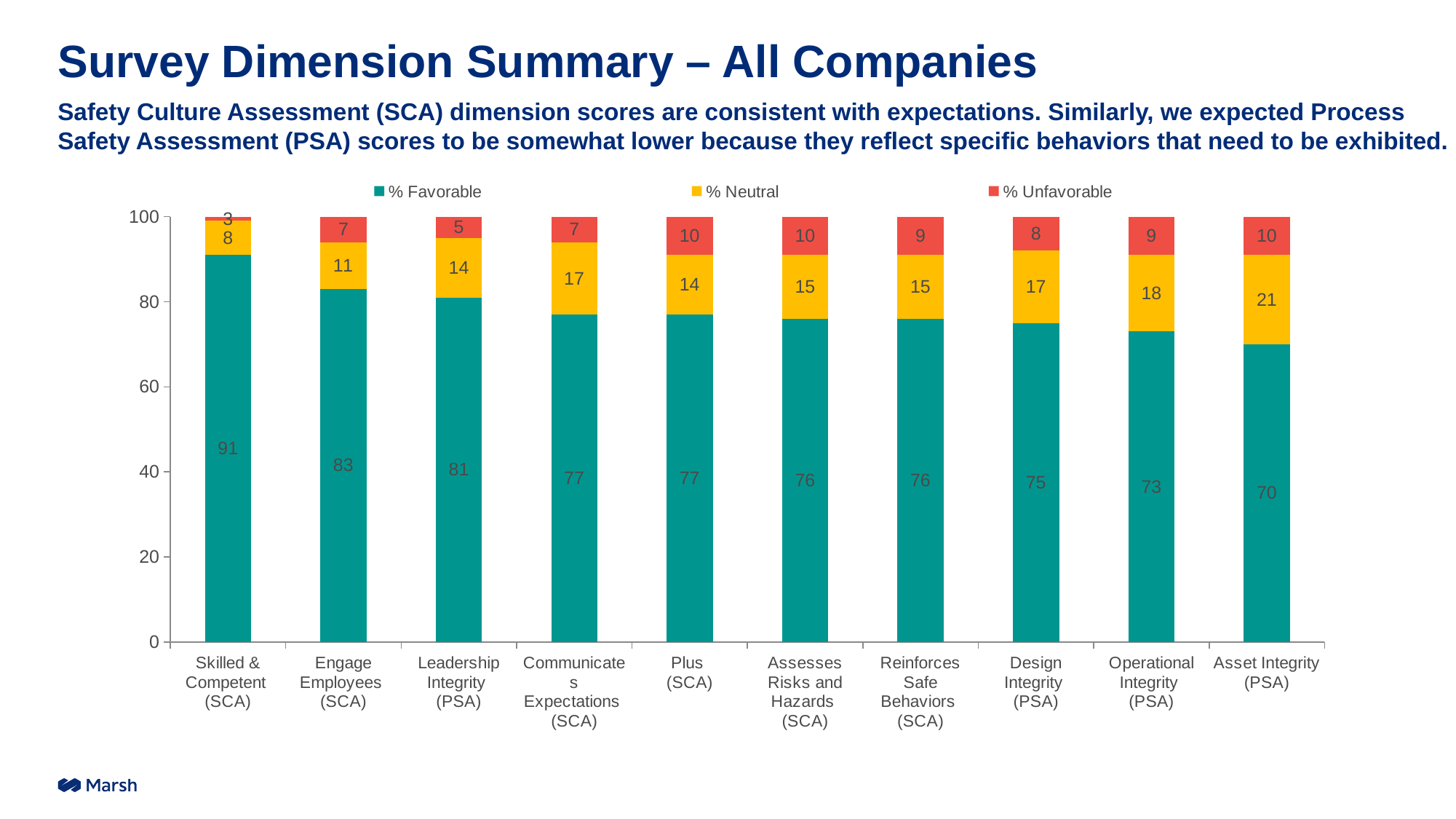
What is the % Unfavorable value for Leadership Integrity (PSA)? 5 How many dimensions are shown on the x axis? 10 Which has a larger % Neutral value, Design Integrity (PSA) or Engage Employees (SCA)? Design Integrity (PSA) How many series does the legend list? 3 Which dimension has the highest % Favorable value? Skilled & Competent (SCA) What is the % Favorable value for Skilled & Competent (SCA)? 91 What is the difference between the % Favorable values for Engage Employees (SCA) and Operational Integrity (PSA)? 10 Which colour represents % Unfavorable in the chart? Red What kind of chart is shown on the slide? Stacked bar chart What is the total of the stacked bar for Plus (SCA)? 101 What is the % Neutral value for Asset Integrity (PSA)? 21 Which dimension has the lowest % Favorable value? Asset Integrity (PSA)